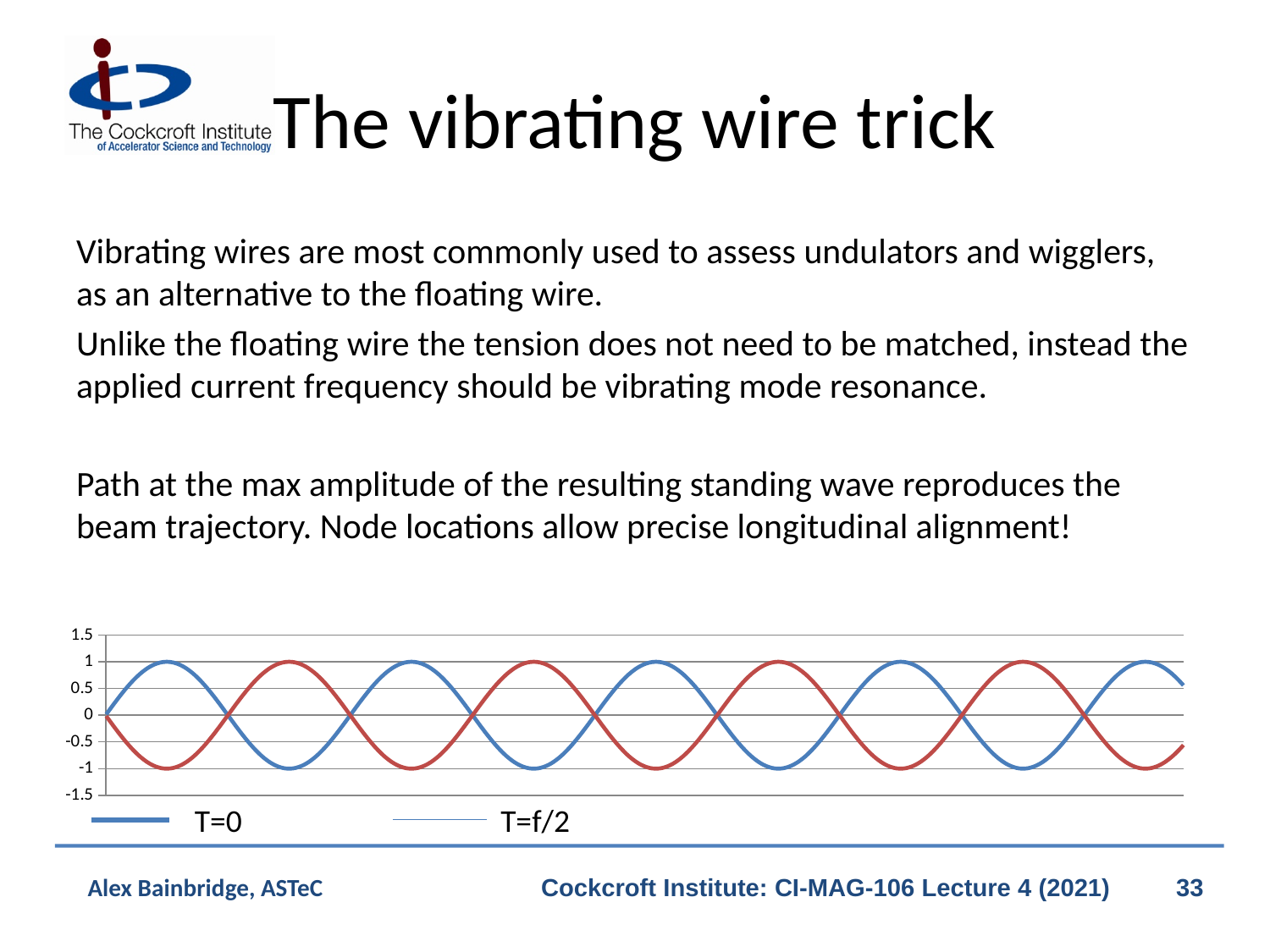
What is the maximum value reached by the blue line in the chart? 1 Is the peak value of the blue line greater or less than 1.5? less What kind of chart is shown at the bottom of the slide? line chart Is the lowest value of the red line greater or less than -1.5? greater What is the highest value shown on the chart's vertical axis? 1.5 What colour is the T=0 series line in the chart? blue What is the lowest value shown on the chart's vertical axis? -1.5 How many series does the chart legend list? 2 What are the two series named in the chart legend? T=0 and T=f/2 How many peaks does the blue line reach across the chart? 5 What is the minimum value reached by the red line in the chart? -1